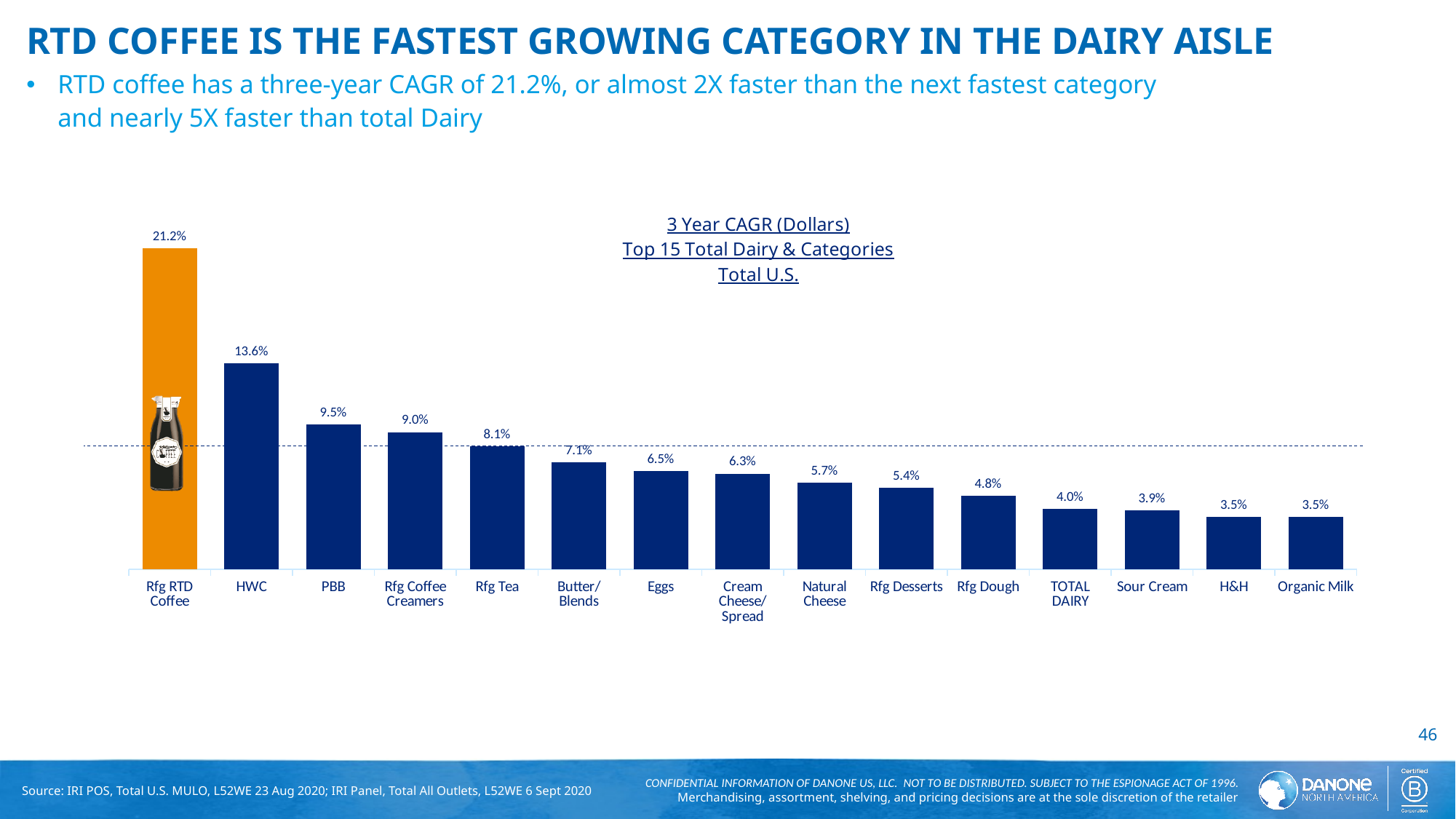
What is the difference between the values for Rfg RTD Coffee and HWC? 7.6% What is the value shown for Rfg Tea? 8.1% Which has a higher 3-year CAGR, Eggs or Natural Cheese? Eggs Which category has the highest 3-year CAGR in the chart? Rfg RTD Coffee What is the 3-year CAGR shown for TOTAL DAIRY? 4.0% What is the difference between the values for PBB and Rfg Coffee Creamers? 0.5% What is the 3-year CAGR shown for Rfg RTD Coffee? 21.2% Which bar in the chart is coloured orange rather than dark blue? Rfg RTD Coffee How many categories are plotted in the chart? 15 What kind of chart is shown on the slide? Bar chart What is the value shown for HWC? 13.6% Which has a higher value, Sour Cream or Rfg Dough? Rfg Dough